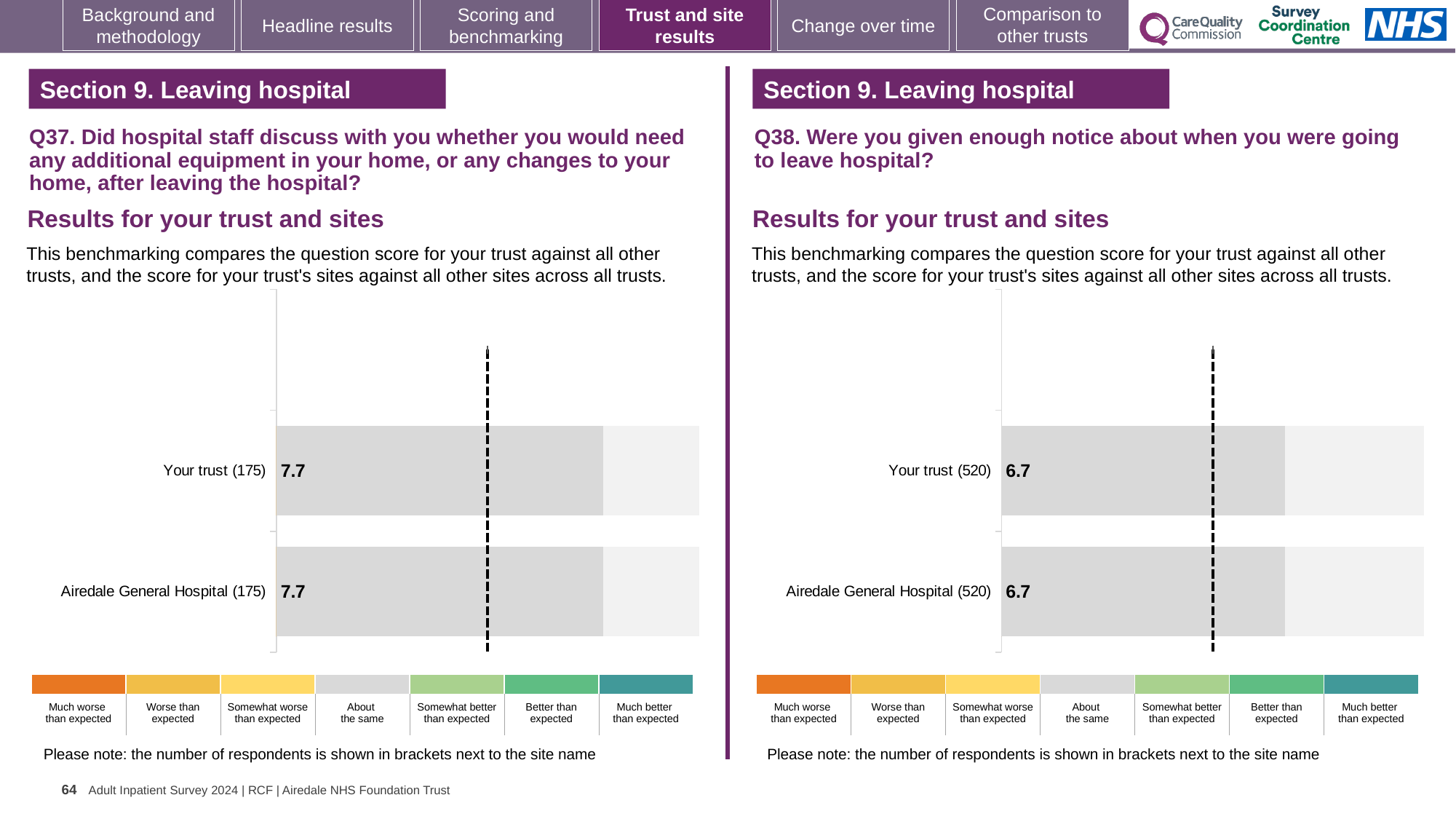
How many bars are plotted in the Q37 chart on the left? 2 How many bars are plotted in the Q38 chart on the right? 2 In the Q37 chart on the left, what is the score for Your trust? 7.7 In the Q37 chart on the left, what is the score for Airedale General Hospital? 7.7 In the Q38 chart on the right, how many respondents are shown in brackets next to Airedale General Hospital? 520 In the Q38 chart on the right, what is the score for Your trust? 6.7 In the Q38 chart on the right, what is the score for Airedale General Hospital? 6.7 In the Q38 chart on the right, what is the difference between the score for Your trust and the score for Airedale General Hospital? 0 In the Q37 chart on the left, how many respondents are shown in brackets next to Your trust? 175 What kind of chart is used for the Q38 results on the right? Bar chart In the Q37 chart on the left, what is the difference between the score for Your trust and the score for Airedale General Hospital? 0